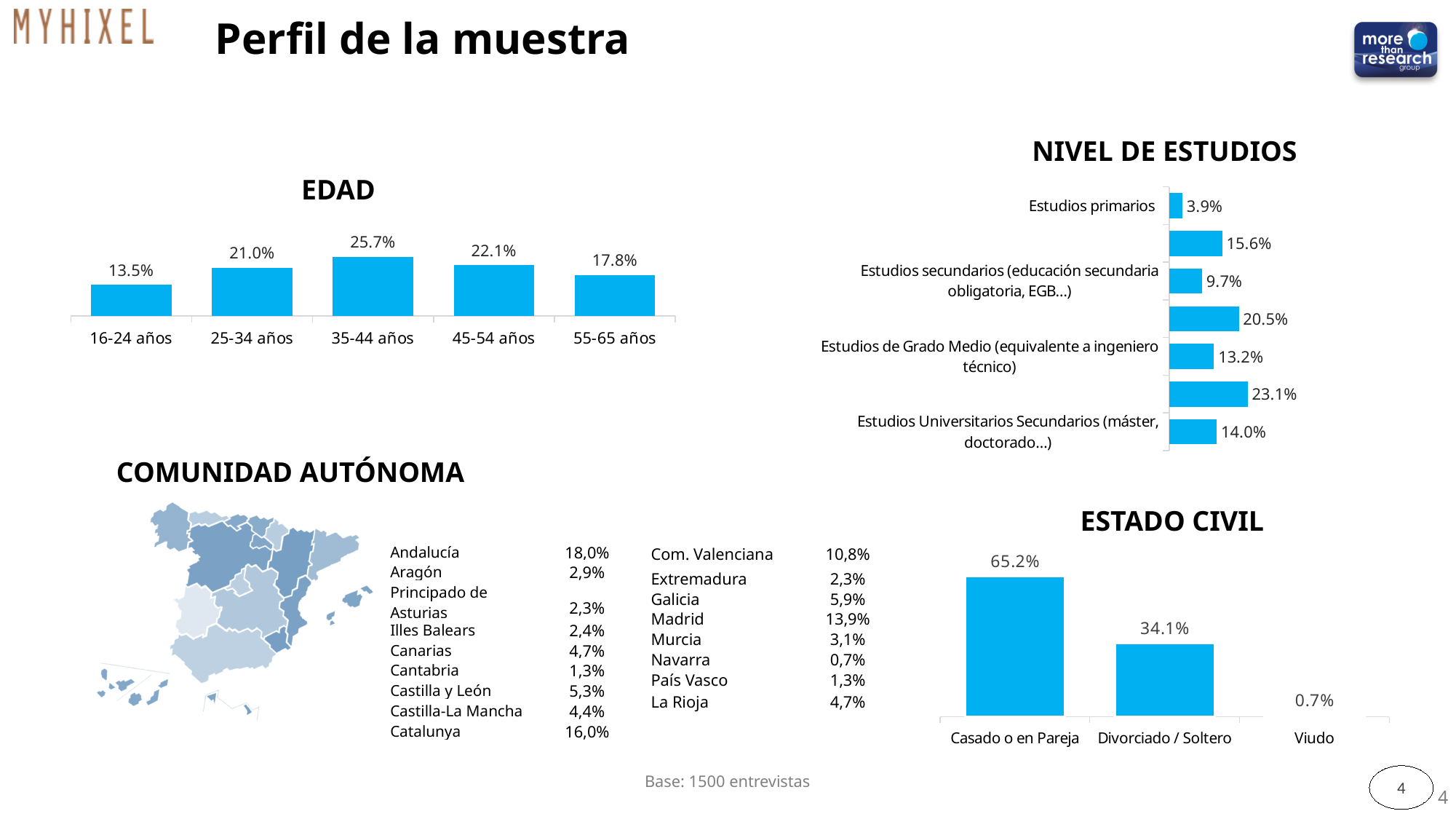
In the EDAD chart, what is the value for 35-44 años? 25.7% What kind of chart is the ESTADO CIVIL chart? Bar chart In the ESTADO CIVIL chart, what is the value for Divorciado / Soltero? 34.1% In the EDAD chart, what is the difference between the values for 45-54 años and 55-65 años? 4.3% In the ESTADO CIVIL chart, what is the difference between Casado o en Pareja and Divorciado / Soltero? 31.1% In the EDAD chart, which age group has the highest value? 35-44 años In the NIVEL DE ESTUDIOS chart, what is the highest value shown on any bar? 23.1% In the NIVEL DE ESTUDIOS chart, how many bars are plotted? 7 In the EDAD chart, how many age groups are shown? 5 In the NIVEL DE ESTUDIOS chart, what is the value for Estudios primarios? 3.9% In the EDAD chart, which age group has the lowest value? 16-24 años In the EDAD chart, which is larger, the value for 25-34 años or the value for 45-54 años? 45-54 años